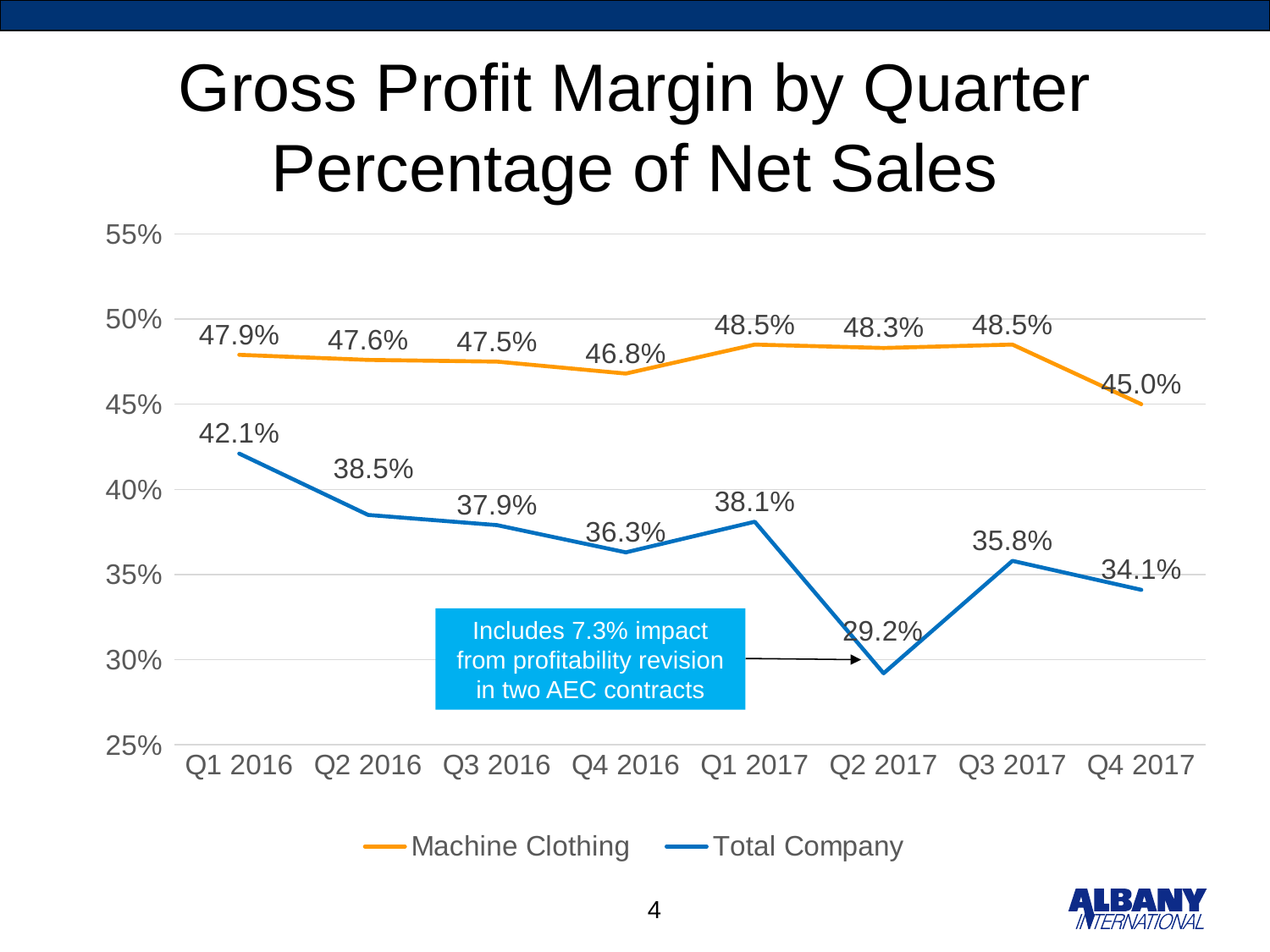
Which is larger, the Total Company margin in Q1 2017 or in Q3 2017? Q1 2017 How many quarters are shown on the x axis? 8 What is the Machine Clothing gross profit margin in Q1 2016? 47.9% What is the difference between the Machine Clothing and Total Company gross profit margins in Q4 2017? 10.9% In which quarter is the Total Company gross profit margin lowest? Q2 2017 In which quarter is the Machine Clothing gross profit margin lowest? Q4 2017 What is the Total Company gross profit margin in Q2 2017? 29.2% Which series is drawn in orange? Machine Clothing In which quarter is the Total Company gross profit margin highest? Q1 2016 How many series does the legend list? 2 What is the Total Company gross profit margin in Q4 2017? 34.1% What kind of chart is shown on the slide? Line chart